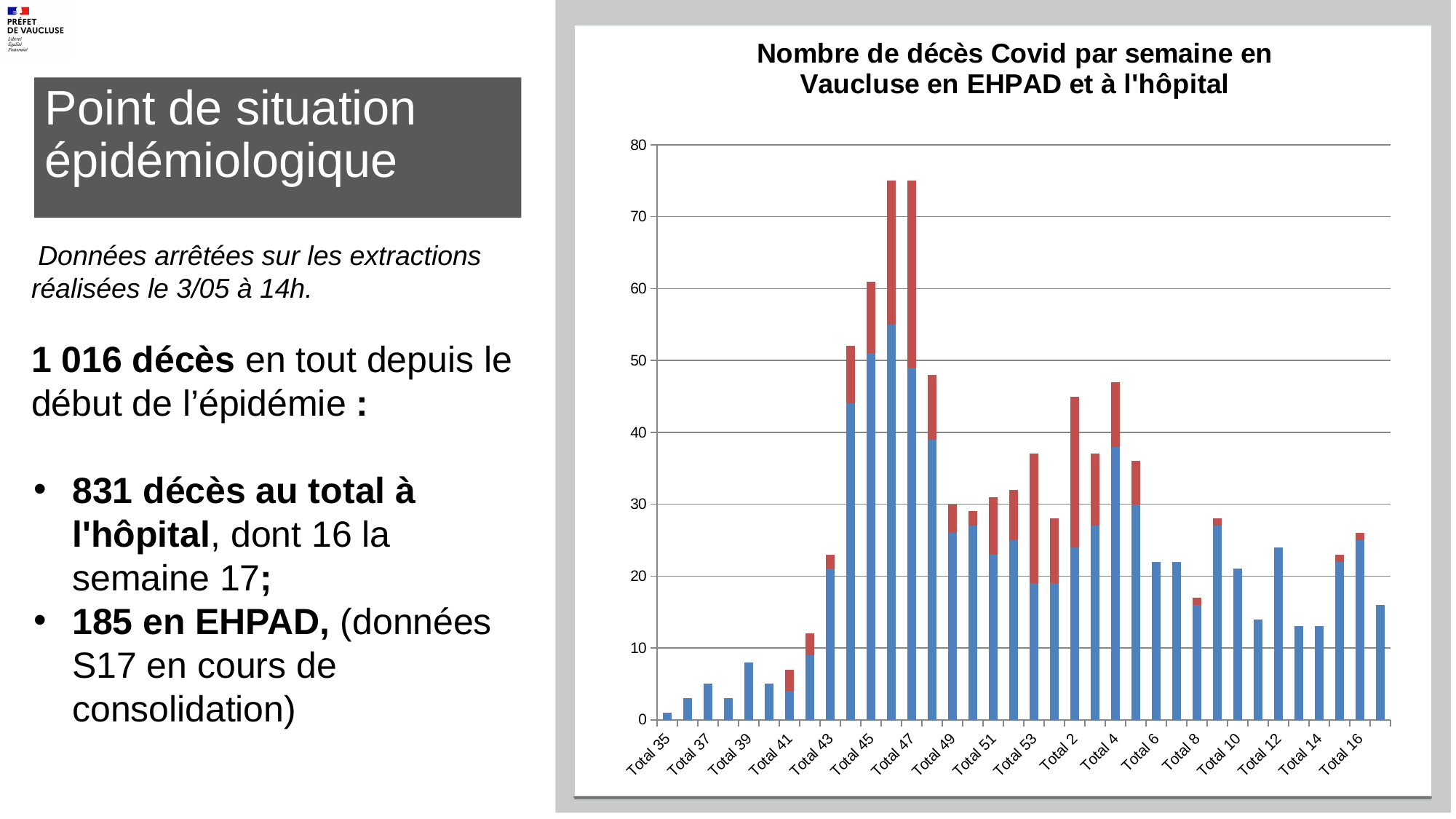
Do the total values generally rise or fall from Total 35 to Total 47? rise Which has the larger total bar, Total 43 or Total 45? Total 45 Which category has the lowest total bar in the chart? Total 35 Is the total value for Total 8 greater or less than 20? less What kind of chart is shown on the slide? bar chart Is the total value for Total 47 greater or less than 70? greater Which has the larger total bar, Total 47 or Total 49? Total 47 Is the total value for Total 2 greater or less than 40? greater What is the title of the chart? Nombre de décès Covid par semaine en Vaucluse en EHPAD et à l'hôpital